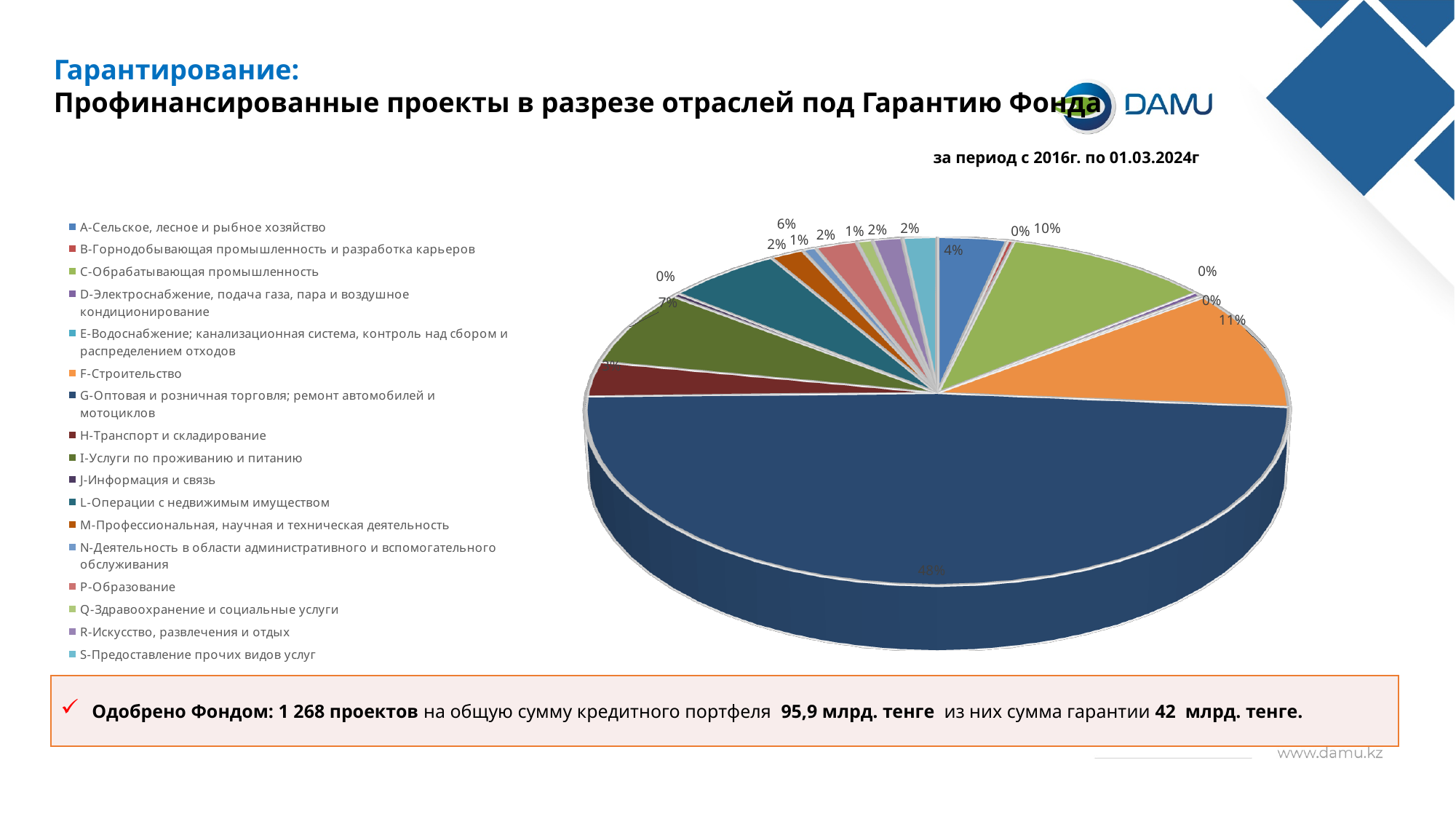
Which sector has the largest share of the pie? G-Оптовая и розничная торговля; ремонт автомобилей и мотоциклов What share of the pie does C-Обрабатывающая промышленность have? 10% What colour is the slice for G-Оптовая и розничная торговля; ремонт автомобилей и мотоциклов? dark blue What is the difference between the shares of F-Строительство and C-Обрабатывающая промышленность? 1% What period does the chart cover, according to the text above it? за период с 2016г. по 01.03.2024г What share of the pie does I-Услуги по проживанию и питанию have? 7% What share of the pie does F-Строительство have? 11% What kind of chart is shown on the slide? pie chart Which is larger, the share for F-Строительство or the share for C-Обрабатывающая промышленность? F-Строительство How many sectors does the legend list? 17